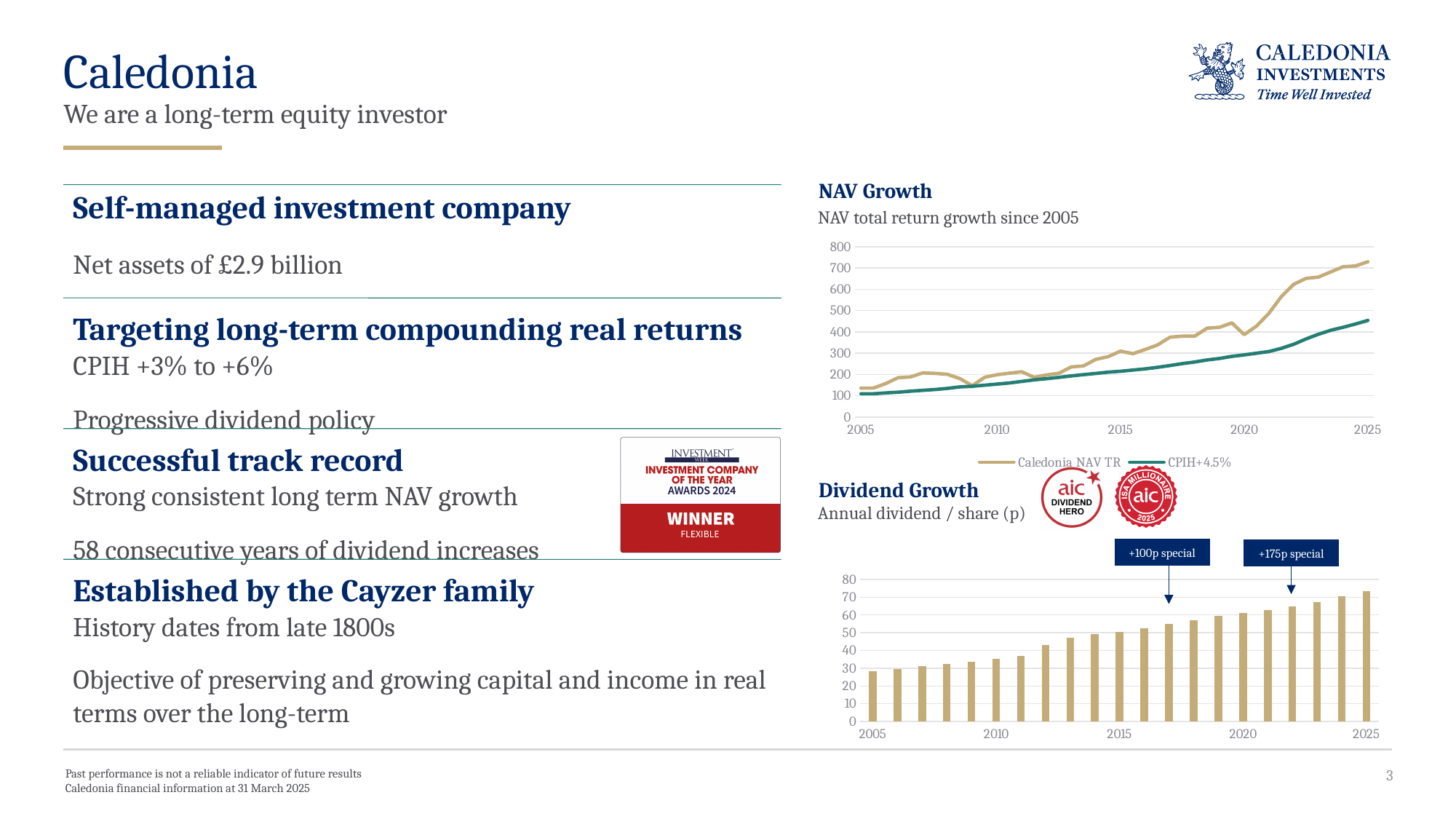
In the Dividend Growth chart, which year has the lowest annual dividend per share? 2005 What kind of chart is the NAV Growth chart? line chart In the NAV Growth chart, is the value for Caledonia NAV TR in 2025 greater or less than 600? greater In the NAV Growth chart, do the Caledonia NAV TR values generally rise or fall from 2005 to 2025? rise In the NAV Growth chart, which series is higher in 2025, Caledonia NAV TR or CPIH+4.5%? Caledonia NAV TR In the Dividend Growth chart, what special dividend is annotated above the 2022 bar? +175p special How many bars are plotted in the Dividend Growth chart? 21 How many series does the legend of the NAV Growth chart list? 2 What kind of chart is the Dividend Growth chart? bar chart In the NAV Growth chart, is the value for CPIH+4.5% in 2025 greater or less than 500? less In the Dividend Growth chart, which year has the highest annual dividend per share? 2025 In the Dividend Growth chart, is the value for 2005 greater or less than 40? less